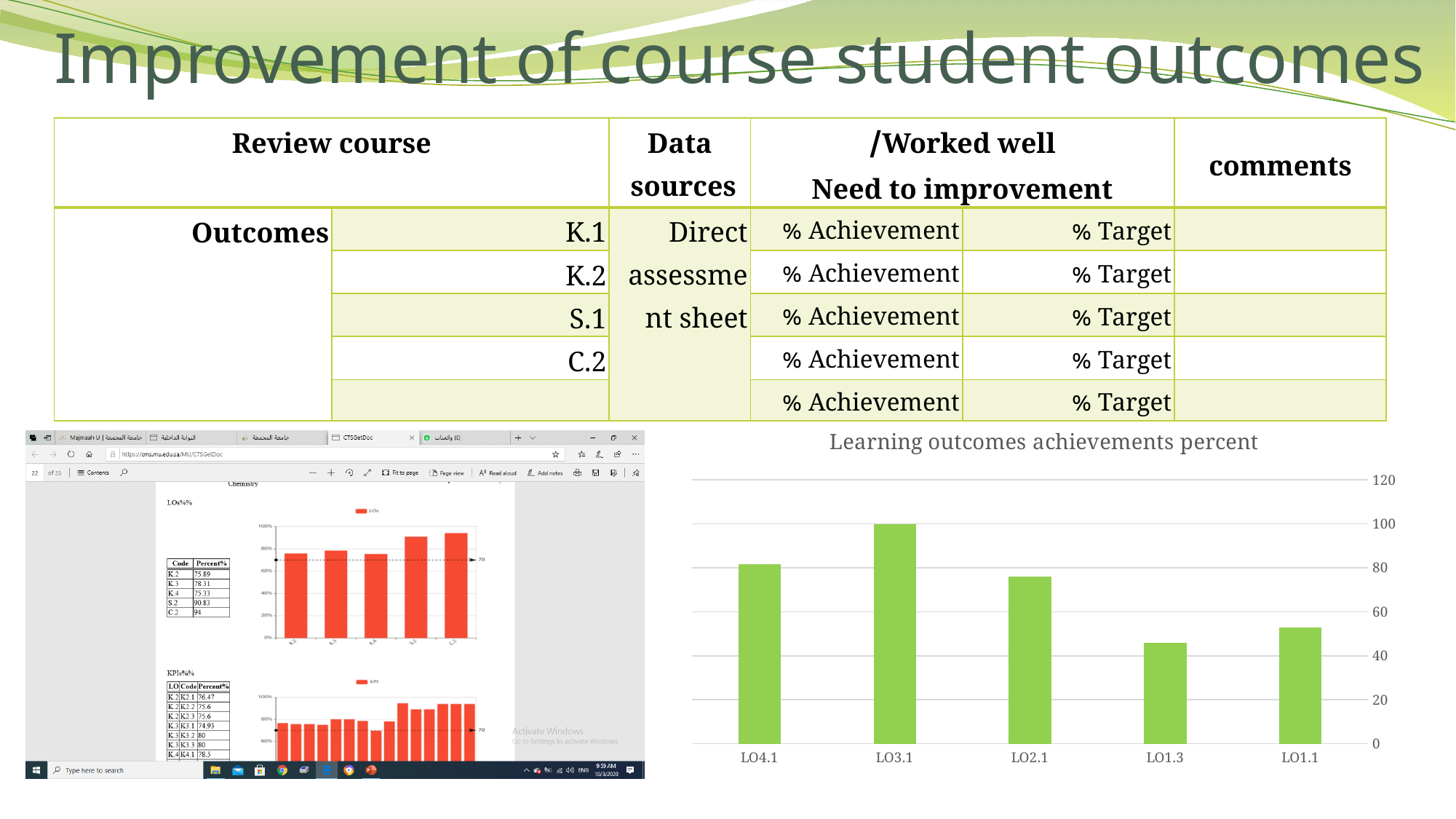
In the 'Learning outcomes achievements percent' chart, is the value for LO1.3 greater or less than 60? less In the 'Learning outcomes achievements percent' chart, is the value for LO2.1 greater or less than 100? less What is the title of the bar chart on the right side of the slide? Learning outcomes achievements percent In the 'Learning outcomes achievements percent' chart, which category has the lowest value? LO1.3 In the 'Learning outcomes achievements percent' chart, which is larger, the value for LO1.1 or the value for LO1.3? LO1.1 What is the highest tick value shown on the y axis of the 'Learning outcomes achievements percent' chart? 120 In the 'Learning outcomes achievements percent' chart, is the value for LO4.1 greater or less than 60? greater How many categories are shown on the x axis of the 'Learning outcomes achievements percent' chart? 5 In the 'Learning outcomes achievements percent' chart, which is larger, the value for LO4.1 or the value for LO2.1? LO4.1 What kind of chart is 'Learning outcomes achievements percent'? bar chart In the 'Learning outcomes achievements percent' chart, which category has the highest value? LO3.1